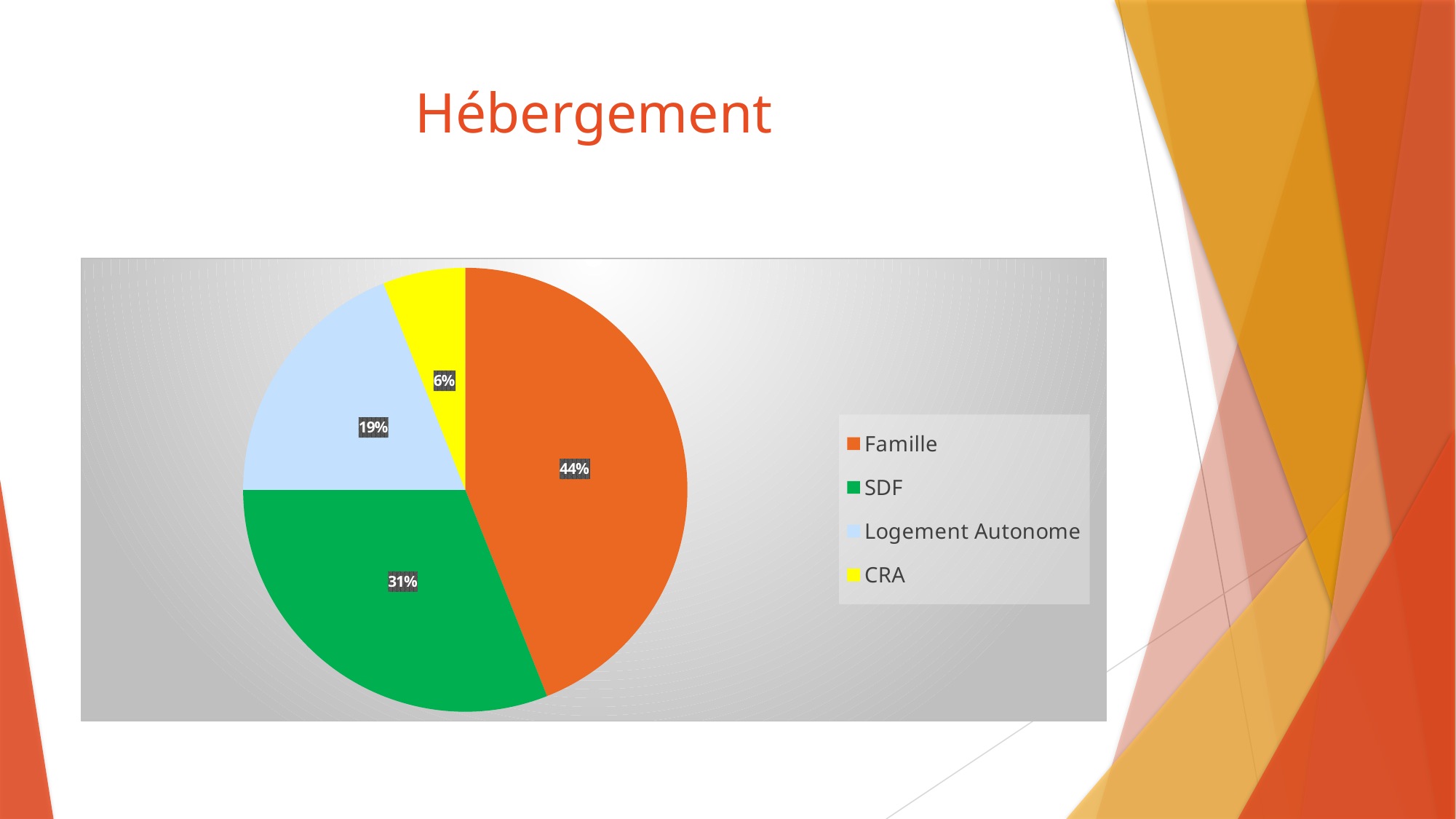
What is the difference in percentage points between Logement Autonome and CRA? 13 What share of the pie does CRA represent? 6% What is the difference in percentage points between Famille and SDF? 13 What share of the pie does Famille represent? 44% Which category has the smallest slice of the pie? CRA How many categories does the pie chart have? 4 Which category has the largest slice of the pie? Famille What is the title of the slide containing the chart? Hébergement Which is larger, the share for SDF or the share for Logement Autonome? SDF What share of the pie does SDF represent? 31% What kind of chart is shown on the slide? pie chart